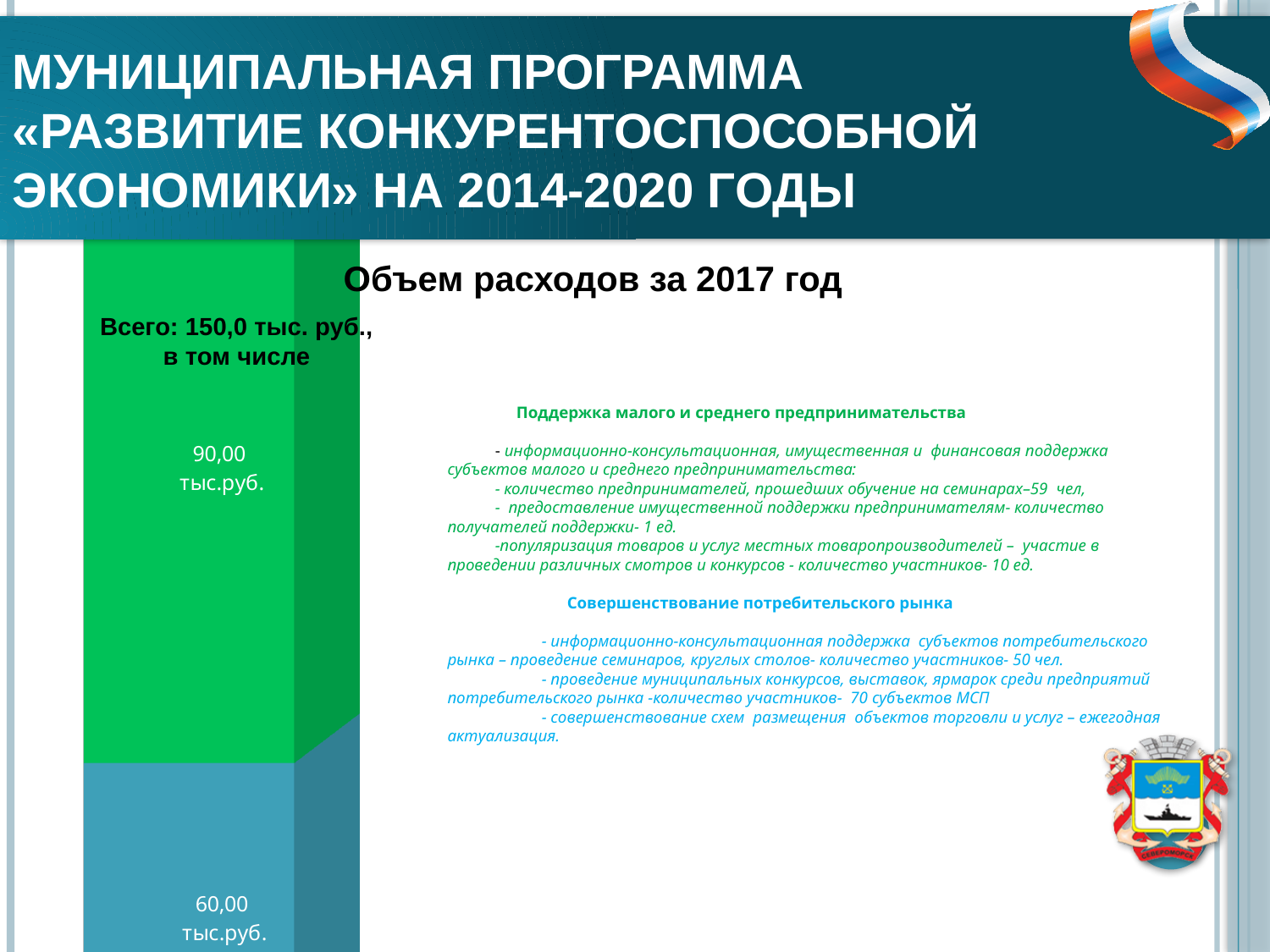
What value is labelled on the green segment of the bar? 90,00 тыс.руб. How many segments make up the stacked bar? 2 What colour is the top segment of the stacked bar? Green What is the difference between the green segment and the blue segment of the bar? 30,00 тыс.руб. What is the title of the chart on the slide? Объем расходов за 2017 год What kind of chart is shown on the slide? Stacked bar chart Which segment of the bar has the smallest value? The blue segment (60,00 тыс.руб.) Which segment of the bar is larger, the green one or the blue one? The green one What is the total of the stacked bar as stated on the slide? 150,0 тыс. руб. What share of the total does the green segment (90,00 тыс.руб.) represent? 60% What value is labelled on the blue segment of the bar? 60,00 тыс.руб. What share of the total does the blue segment (60,00 тыс.руб.) represent? 40%